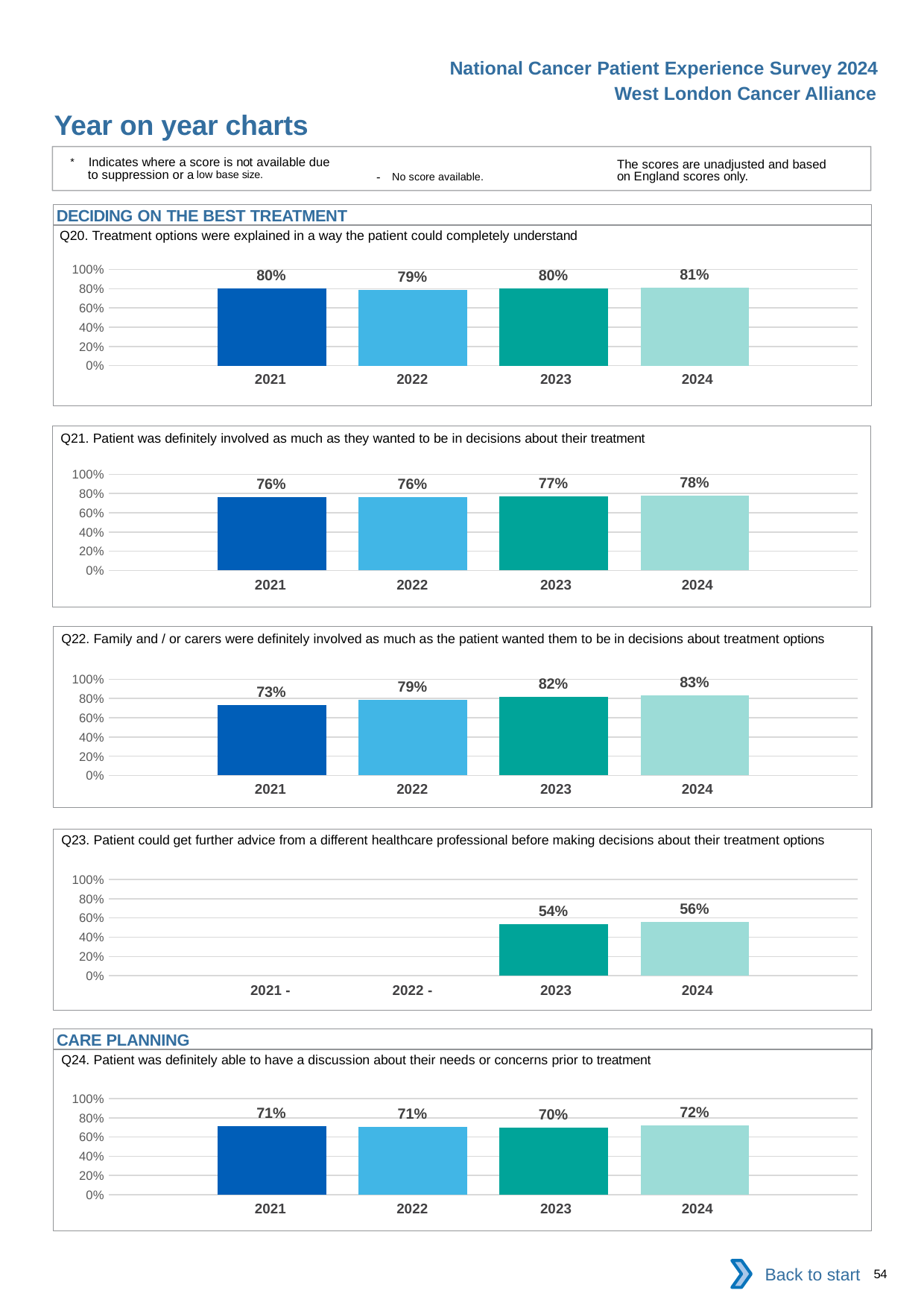
In the Q24 chart, what is the value for 2021? 71% In the Q23 chart, what is the value for 2023? 54% In the Q23 chart, is the value for 2024 greater or less than 40%? greater What kind of chart is the Q21 chart? bar chart In the Q20 chart, how many years are shown on the x axis? 4 In the Q22 chart, which year has the lowest value? 2021 In the Q23 chart, how many years have a bar plotted? 2 In the Q22 chart, do the values rise or fall from 2021 to 2024? rise In the Q24 chart, which is larger, the value for 2023 or the value for 2024? 2024 In the Q22 chart, what is the difference between the 2024 value and the 2021 value? 10% In the Q21 chart, which year has the highest value? 2024 In the Q20 chart, what is the value for 2024? 81%